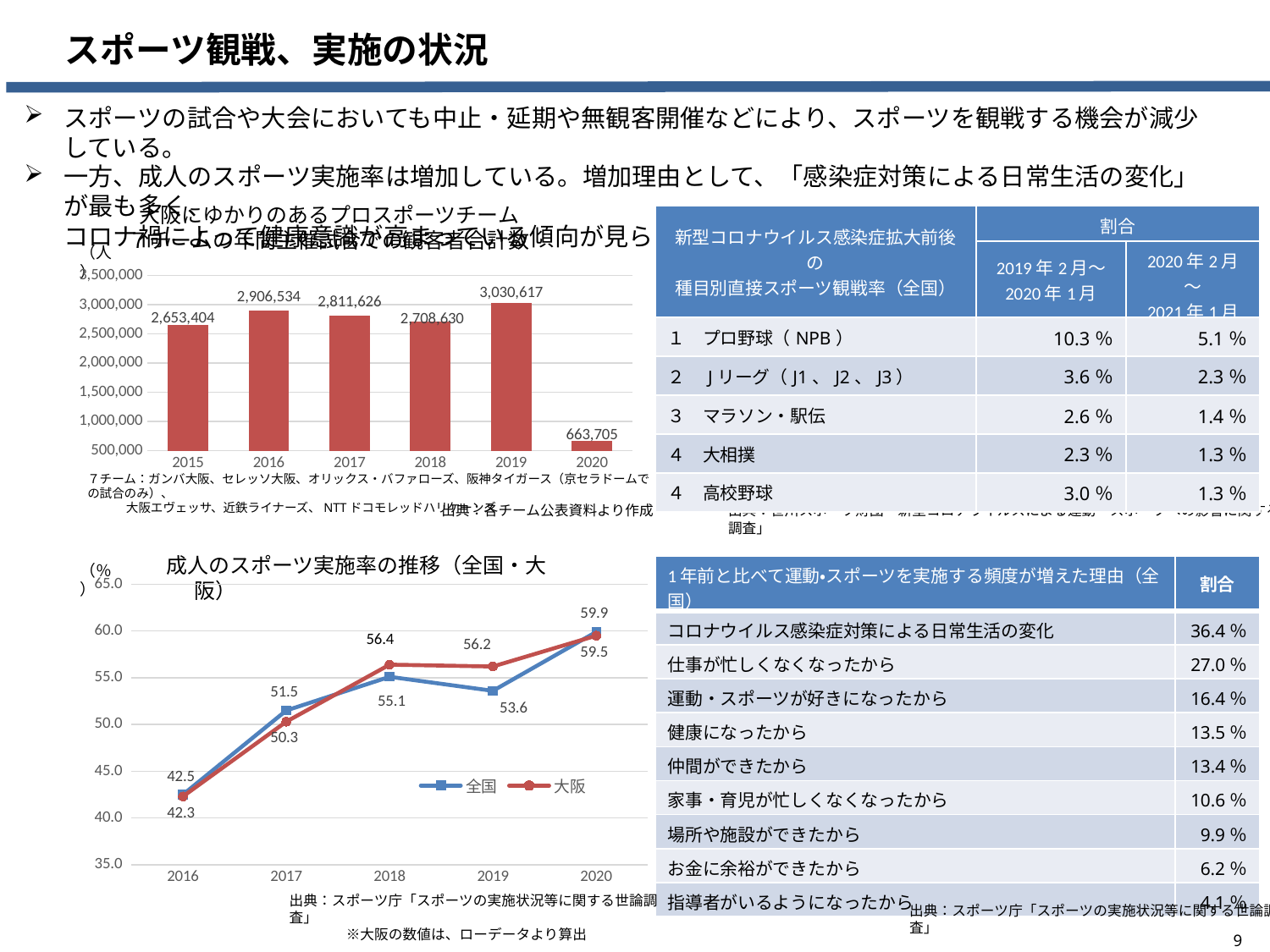
In the bar chart at the top left of the slide, what is the difference between the 2016 value and the 2015 value? 253,130 In the bar chart at the top left of the slide, how many years are shown on the x axis? 6 In the bar chart at the top left of the slide, which year has the lowest value? 2020 In the chart titled 成人のスポーツ実施率の推移（全国・大阪）, which series has the higher value in 2017, 全国 or 大阪? 全国 In the chart titled 成人のスポーツ実施率の推移（全国・大阪）, does the 大阪 series rise or fall from 2016 to 2020 overall? Rise In the bar chart at the top left of the slide, which year has the highest value? 2019 In the chart titled 成人のスポーツ実施率の推移（全国・大阪）, what is the value for 全国 in 2019? 53.6 In the bar chart at the top left of the slide, what is the value for 2020? 663,705 What kind of chart is the chart at the top left of the slide? Bar chart In the chart titled 成人のスポーツ実施率の推移（全国・大阪）, how many series does the legend list? 2 In the bar chart at the top left of the slide, what is the value for 2019? 3,030,617 In the chart titled 成人のスポーツ実施率の推移（全国・大阪）, what is the value for 大阪 in 2018? 56.4